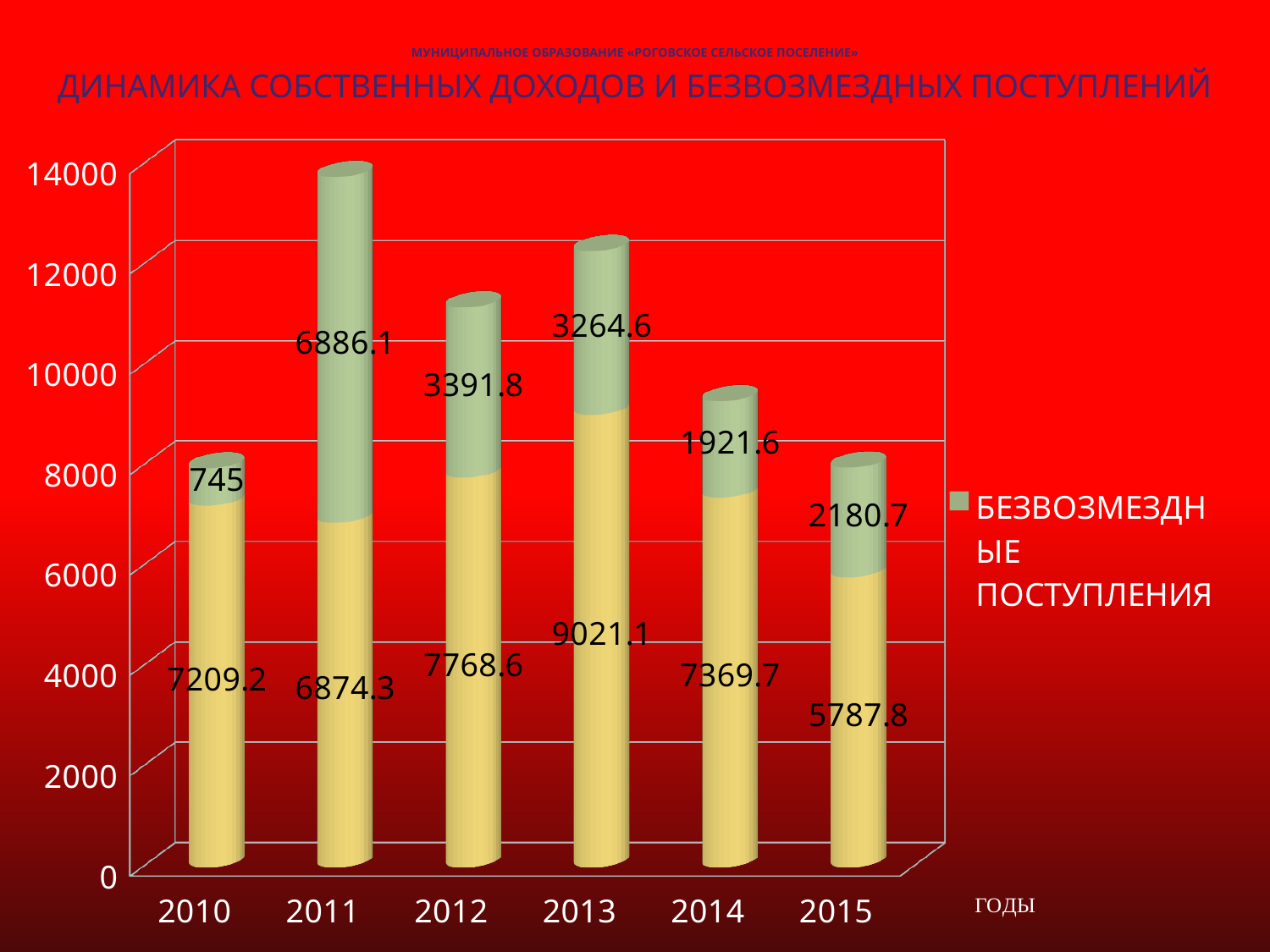
How many years are shown on the x axis? 6 What kind of chart is shown on the slide? Stacked bar chart In which year is the lower yellow segment the smallest? 2015 In which year is БЕЗВОЗМЕЗДНЫЕ ПОСТУПЛЕНИЯ highest? 2011 What is the value of БЕЗВОЗМЕЗДНЫЕ ПОСТУПЛЕНИЯ for 2010? 745 In which year is БЕЗВОЗМЕЗДНЫЕ ПОСТУПЛЕНИЯ lowest? 2010 Which is larger: the lower yellow segment in 2012 or in 2014? 2012 What is the difference between БЕЗВОЗМЕЗДНЫЕ ПОСТУПЛЕНИЯ in 2012 and in 2013? 127.2 How many series does the legend list? 1 What is the value of БЕЗВОЗМЕЗДНЫЕ ПОСТУПЛЕНИЯ for 2011? 6886.1 What is the total of the stacked bar for 2010? 7954.2 What is the value of the lower yellow segment for 2013? 9021.1